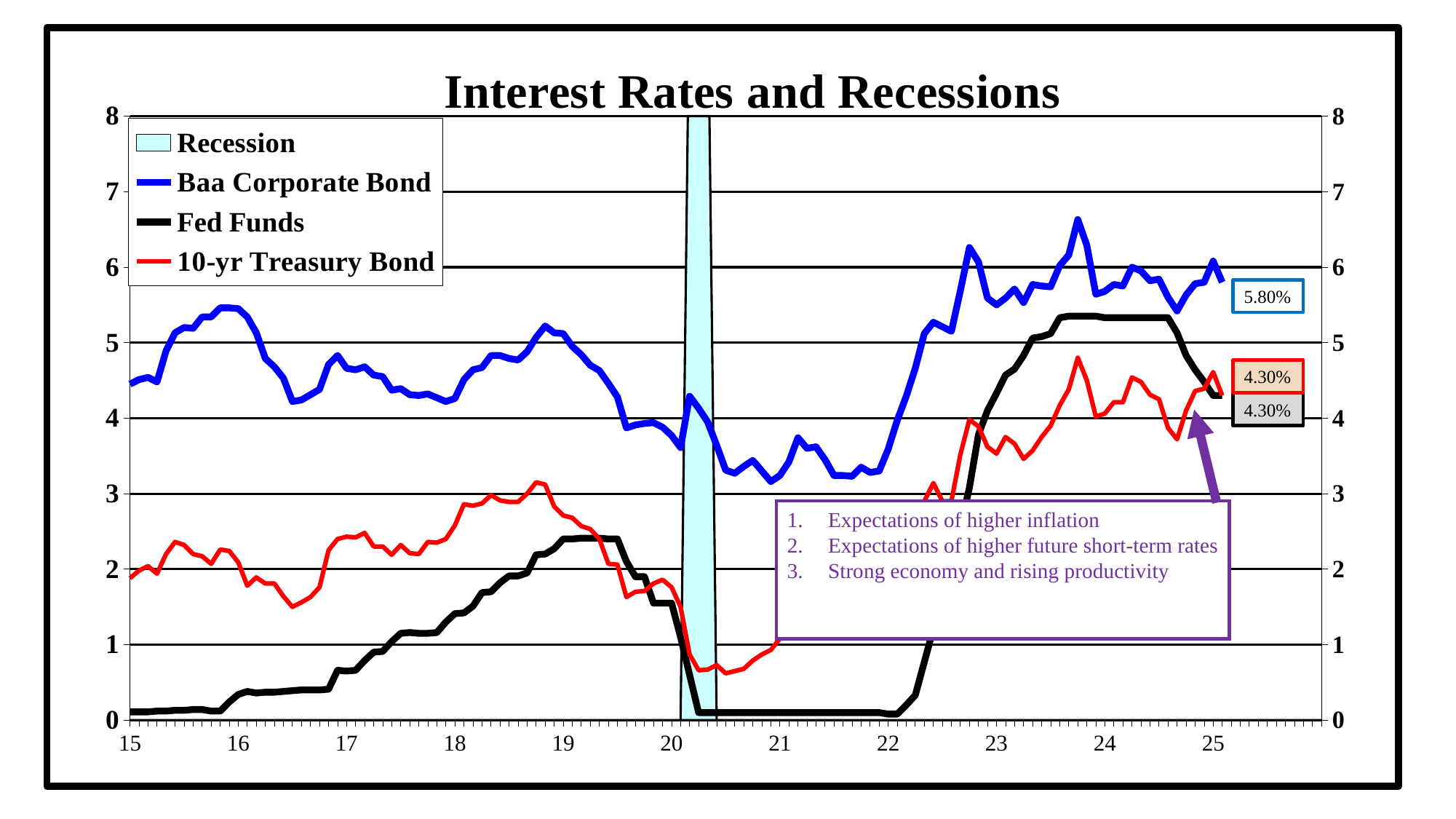
Which series has the highest value at the right end of the chart? Baa Corporate Bond What is the difference between the latest labelled Baa Corporate Bond value and the latest labelled 10-yr Treasury Bond value? 1.50% Does the Fed Funds series rise or fall between 22 and 23 on the x axis? rise At 17 on the x axis, which is higher: the Baa Corporate Bond or the Fed Funds rate? Baa Corporate Bond What is the latest labelled value for the 10-yr Treasury Bond series? 4.30% What is the latest labelled value for the Baa Corporate Bond series? 5.80% How many entries does the chart's legend list? 4 Is the Fed Funds value at 21 on the x axis greater or less than 1? less What is the latest labelled value for the Fed Funds series? 4.30% What kind of chart is shown on the slide? line chart Is the peak of the Baa Corporate Bond series between 23 and 24 on the x axis greater or less than 6? greater What is the title of the chart? Interest Rates and Recessions